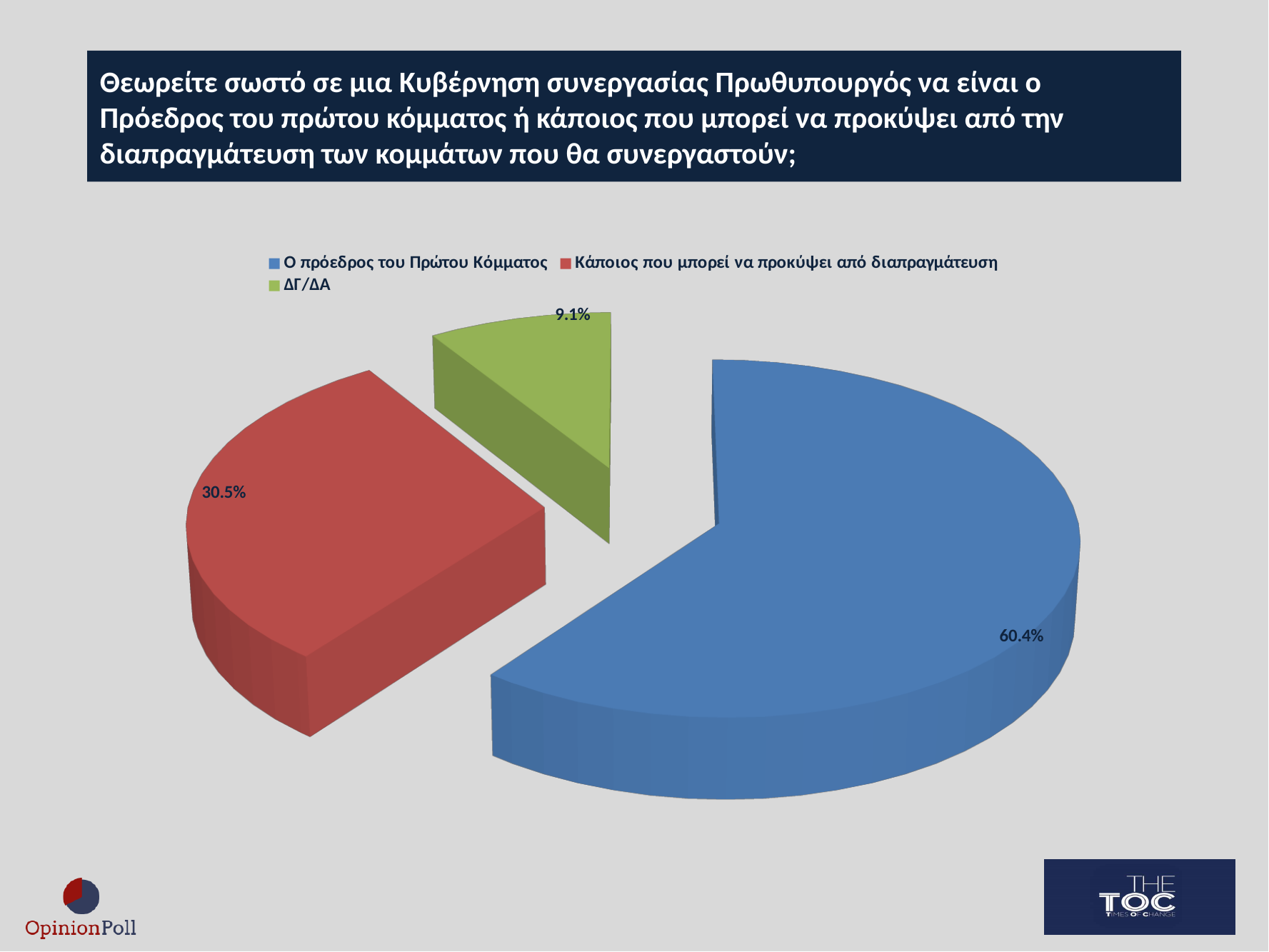
How many entries does the legend list? 3 What percentage is shown for 'Ο πρόεδρος του Πρώτου Κόμματος'? 60.4% What colour is the slice for 'ΔΓ/ΔΑ'? Green What kind of chart is shown on the slide? Pie chart What is the difference in percentage points between 'Ο πρόεδρος του Πρώτου Κόμματος' and 'Κάποιος που μπορεί να προκύψει από διαπραγμάτευση'? 29.9 What percentage is shown for 'ΔΓ/ΔΑ'? 9.1% Which category has the smallest share of the pie? ΔΓ/ΔΑ What percentage is shown for 'Κάποιος που μπορεί να προκύψει από διαπραγμάτευση'? 30.5% What is the difference in percentage points between 'Κάποιος που μπορεί να προκύψει από διαπραγμάτευση' and 'ΔΓ/ΔΑ'? 21.4 How many slices does the pie chart have? 3 Which category has the largest share of the pie? Ο πρόεδρος του Πρώτου Κόμματος Which is larger: the share for 'Κάποιος που μπορεί να προκύψει από διαπραγμάτευση' or the share for 'ΔΓ/ΔΑ'? Κάποιος που μπορεί να προκύψει από διαπραγμάτευση